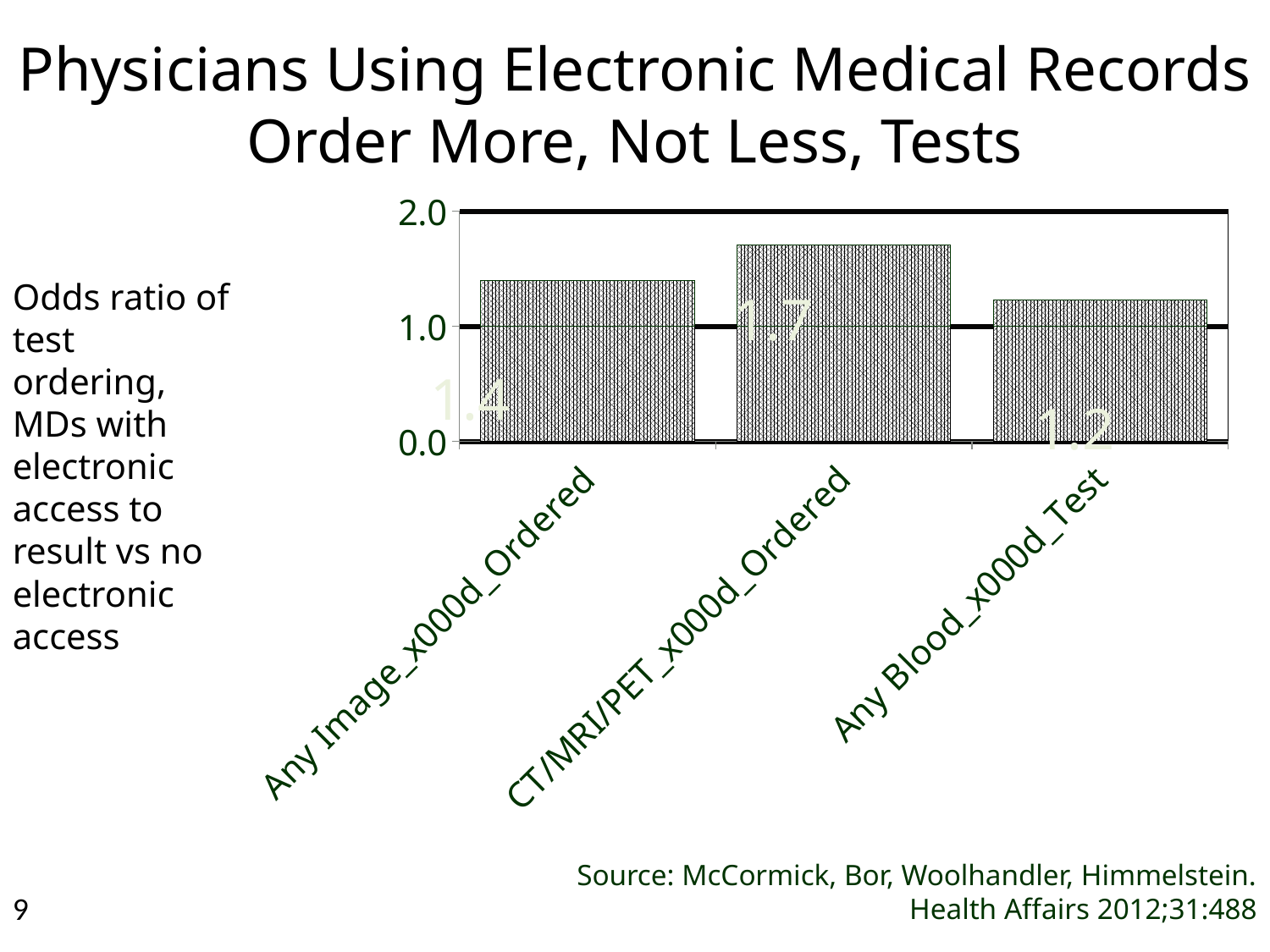
Which category has the highest odds ratio? CT/MRI/PET Ordered What is the odds ratio shown for Any Image Ordered? 1.4 What is the difference between the odds ratios for CT/MRI/PET Ordered and Any Blood Test? 0.5 Which is larger, the odds ratio for Any Image Ordered or for CT/MRI/PET Ordered? CT/MRI/PET Ordered What is the maximum value shown on the vertical axis? 2.0 Is the value for Any Blood Test greater or less than 1.0? greater What kind of chart is shown on the slide? Bar chart What is the odds ratio shown for CT/MRI/PET Ordered? 1.7 What is the odds ratio shown for Any Blood Test? 1.2 Which category has the lowest odds ratio? Any Blood Test How many categories are shown in the chart? 3 What is the difference between the odds ratios for Any Image Ordered and Any Blood Test? 0.2